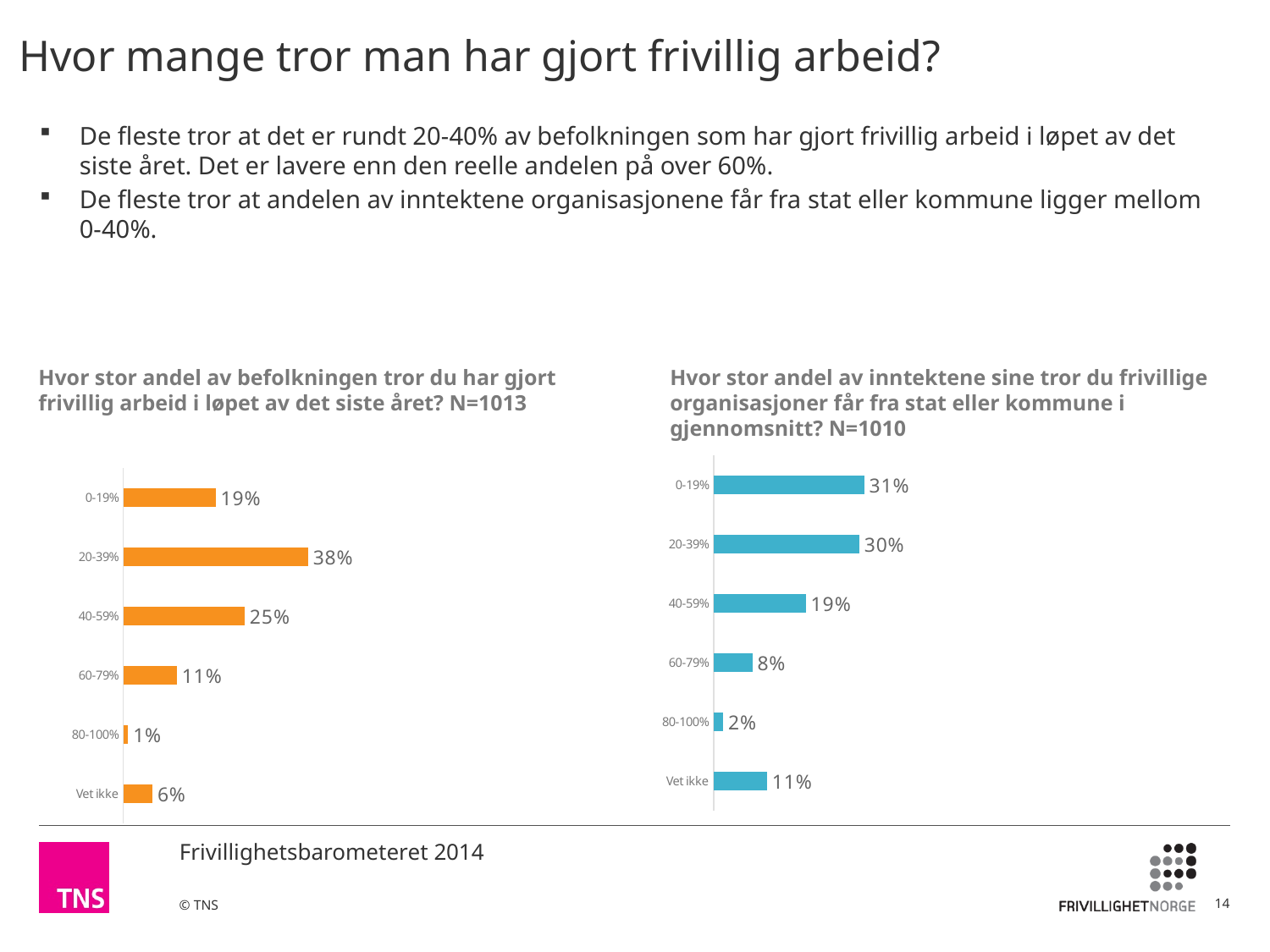
In the right chart (share of income from state or municipality), what is the value for Vet ikke? 11% In the left chart (share of population believed to have done voluntary work), what is the value for 20-39%? 38% In the left chart (share of population believed to have done voluntary work), what is the difference between the values for 20-39% and 40-59%? 13 percentage points In the left chart (share of population believed to have done voluntary work), which category has the highest value? 20-39% In the left chart (share of population believed to have done voluntary work), which category has the lowest value? 80-100% In the right chart (share of income from state or municipality), which category has the lowest value? 80-100% In the right chart (share of income from state or municipality), what is the value for 0-19%? 31% In the left chart (share of population believed to have done voluntary work), how many categories are shown? 6 What colour are the bars in the right chart (share of income from state or municipality)? Blue What kind of chart is the left chart (share of population believed to have done voluntary work)? Bar chart In the right chart (share of income from state or municipality), what is the difference between the values for 0-19% and 80-100%? 29 percentage points In the right chart (share of income from state or municipality), which is larger: the value for 40-59% or the value for 60-79%? 40-59%